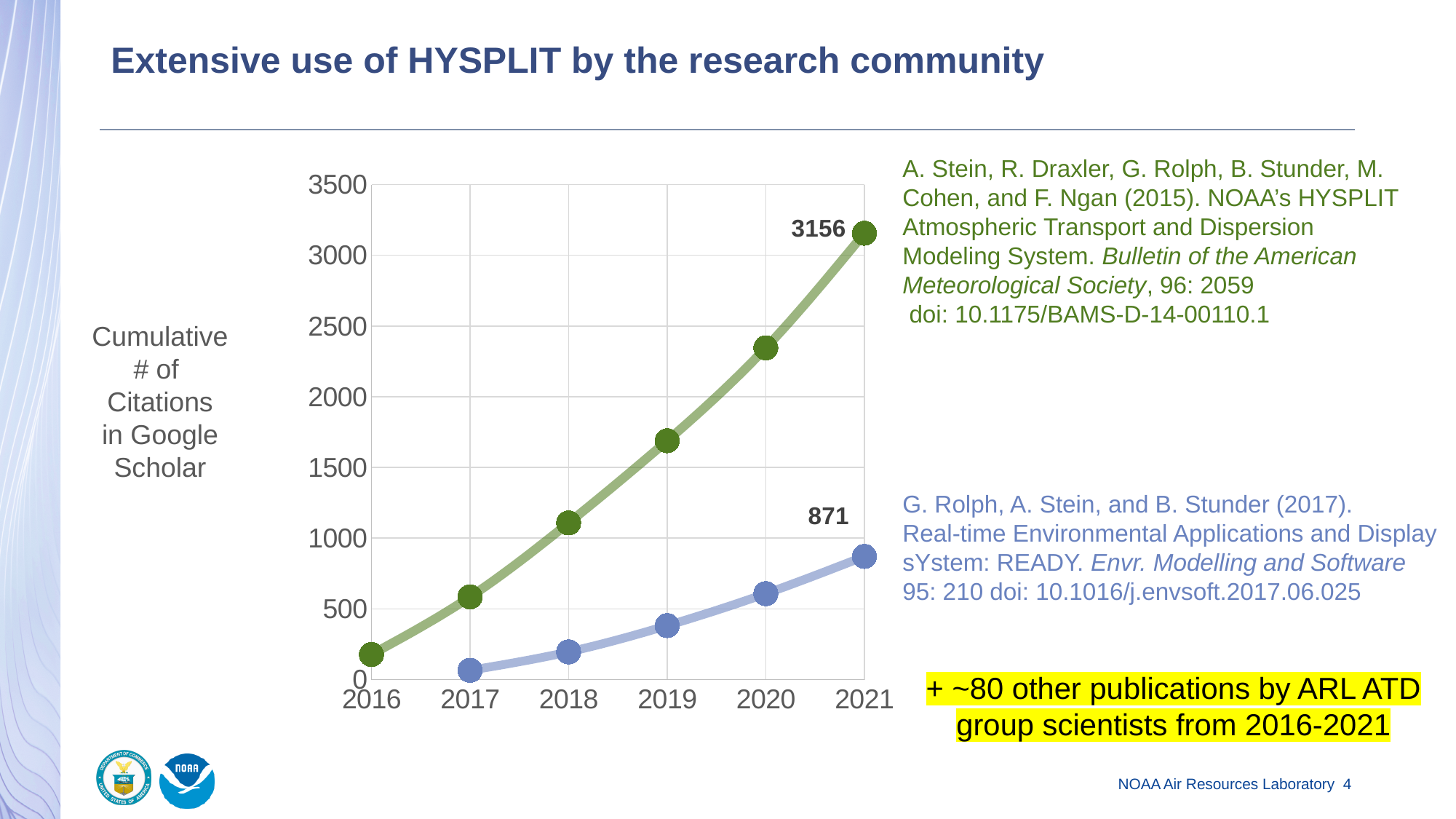
Which line has the higher value in 2021, the green line or the blue line? the green line What is the difference between the 2021 values of the green line (3156) and the blue line (871)? 2285 How many years are shown on the x axis of the chart? 6 Is the value of the blue line in 2017 greater or less than 500? less What does the y axis of the chart represent, according to the label to its left? Cumulative # of Citations in Google Scholar What is the labelled value of the blue line in 2021? 871 What kind of chart is shown on the slide? line chart Is the value of the green line in 2020 greater or less than 2000? greater Is the value of the blue line in 2020 greater or less than 500? greater Do the values of the green line rise or fall from 2016 to 2021? rise What is the labelled value of the green line in 2021? 3156